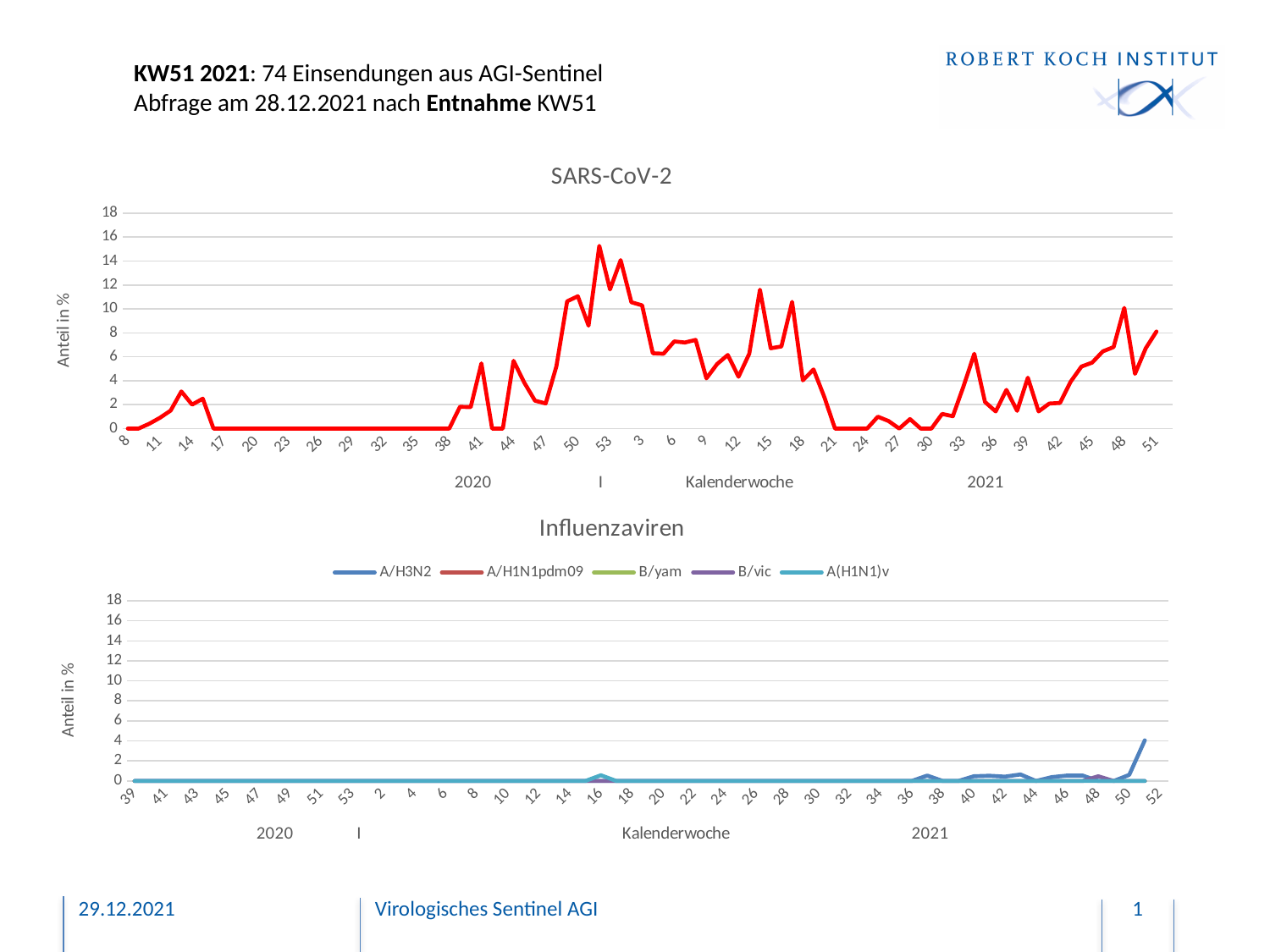
In the SARS-CoV-2 chart, is the value at calendar week 48 of 2021 greater or less than 8? greater In the SARS-CoV-2 chart, is the value at calendar week 53 of 2020 greater or less than 14? less In the SARS-CoV-2 chart, does the line rise or fall between calendar week 42 and calendar week 48 of 2021? rise How many series does the legend of the Influenzaviren chart list? 5 In the SARS-CoV-2 chart, at which calendar week does the line reach its highest value? 52 (2020) What is the y-axis label of the SARS-CoV-2 chart? Anteil in % In the Influenzaviren chart, is the last plotted value of A/H3N2 greater or less than 2? greater Which series are listed in the legend of the Influenzaviren chart? A/H3N2, A/H1N1pdm09, B/yam, B/vic, A(H1N1)v What kind of chart is the SARS-CoV-2 chart? line chart In the SARS-CoV-2 chart, which is larger: the value at week 53 of 2020 or the value at week 48 of 2021? week 53 of 2020 What kind of chart is the Influenzaviren chart? line chart